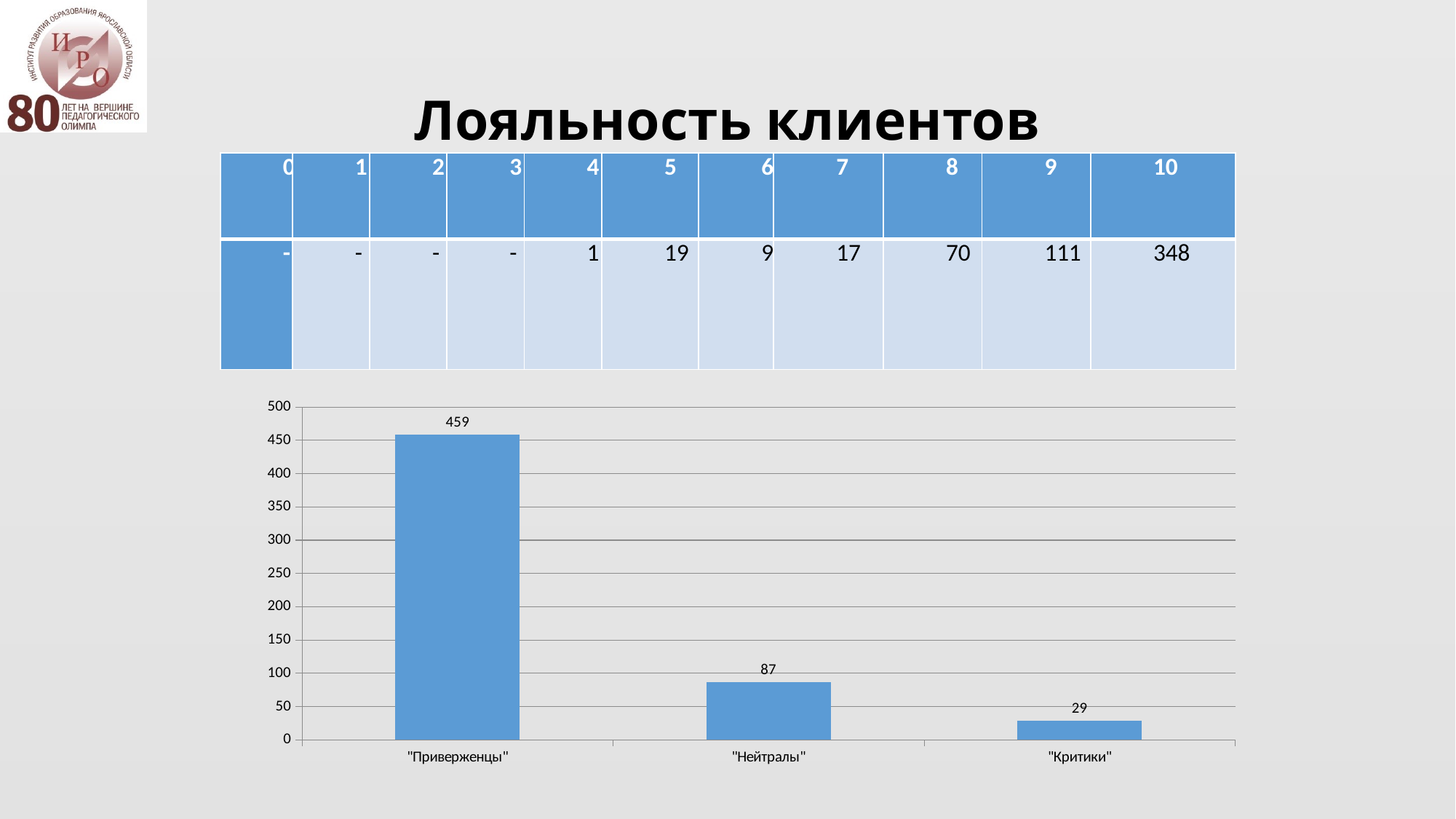
What kind of chart is shown on the slide? bar chart What is the value for "Критики"? 29 What is the difference between the values for "Нейтралы" and "Критики"? 58 Which is larger, the value for "Нейтралы" or the value for "Критики"? "Нейтралы" Is the value for "Приверженцы" greater or less than 400? greater Which category has the highest value? "Приверженцы" Do the values rise or fall from left to right along the x axis? fall What is the difference between the values for "Приверженцы" and "Нейтралы"? 372 How many categories are shown on the chart? 3 What is the value for "Приверженцы"? 459 Which category has the lowest value? "Критики" What is the value for "Нейтралы"? 87